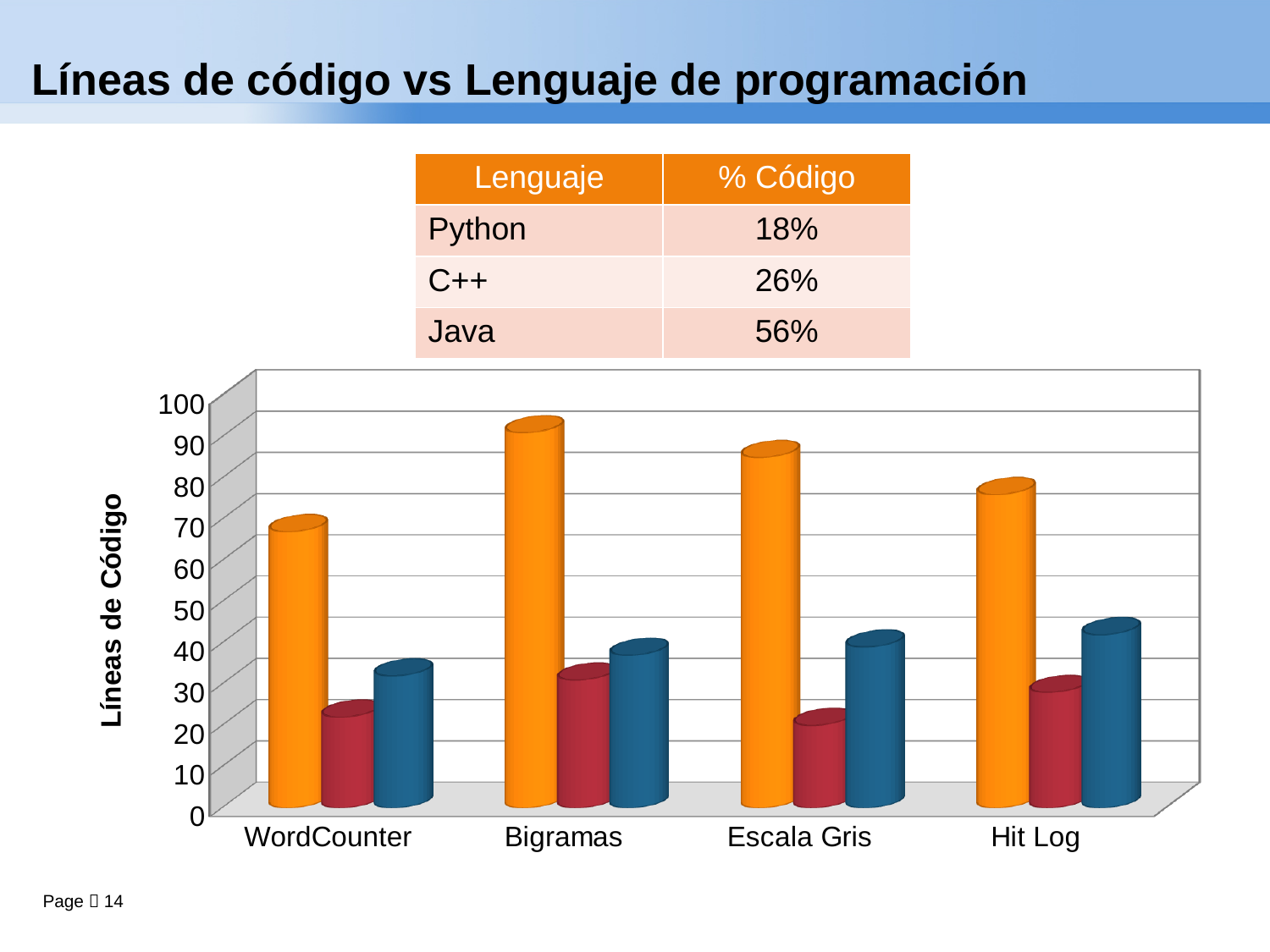
Which category has the larger red bar, Bigramas or Escala Gris? Bigramas For which category is the orange bar the tallest? Bigramas Is the orange bar for WordCounter greater or less than 60? greater What kind of chart is shown on the slide? bar chart For which category is the orange bar the shortest? WordCounter How many categories are shown on the x axis of the chart? 4 What is the title of the vertical axis of the chart? Líneas de Código How many bars are plotted for each category in the chart? 3 Is the orange bar for Bigramas greater or less than 80? greater Is the red bar for Escala Gris greater or less than 30? less Which is larger for Escala Gris, the orange bar or the blue bar? the orange bar